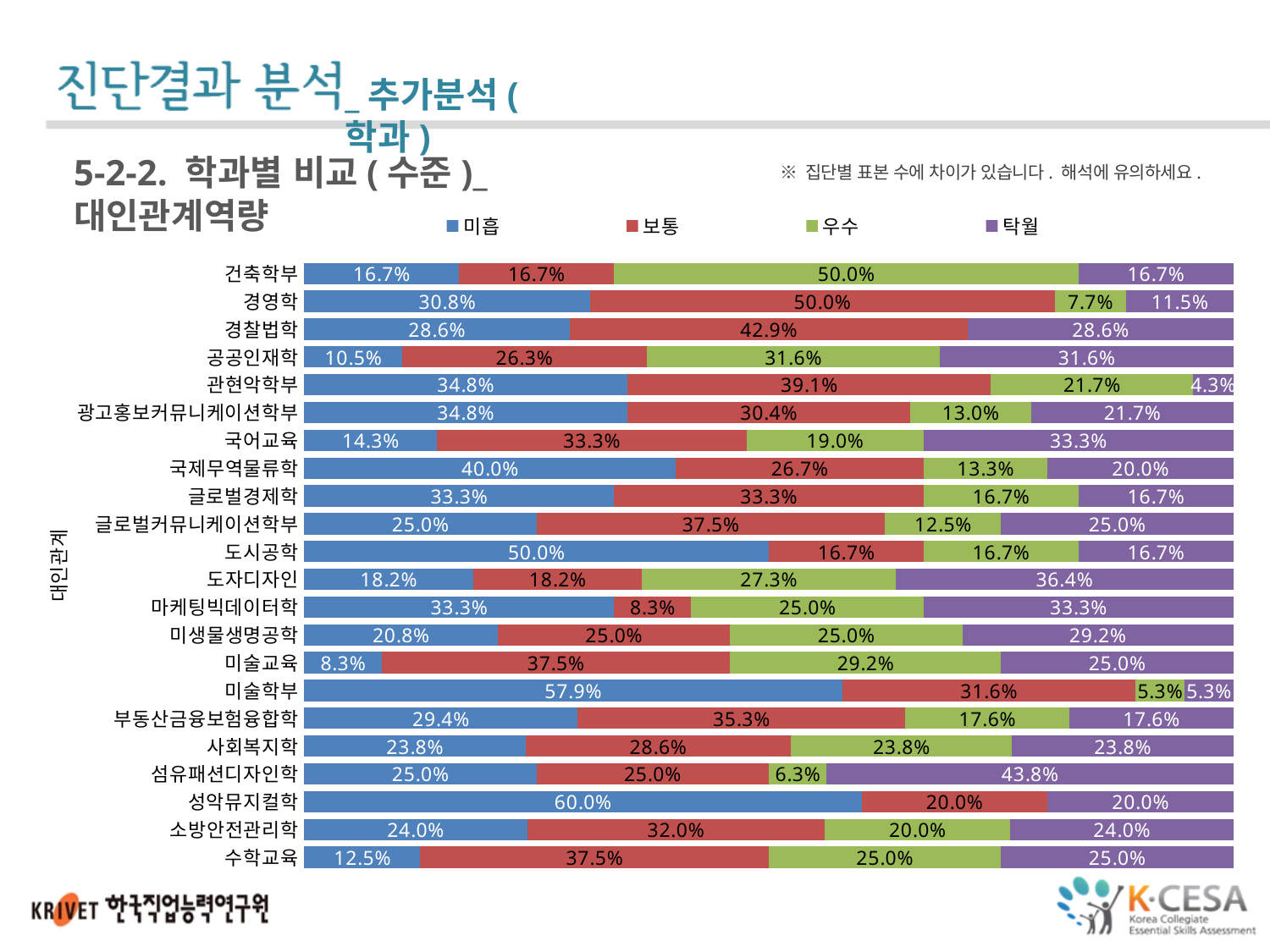
How many series does the legend list? 4 Which legend entry is shown in purple? 탁월 What kind of chart is shown on the slide? stacked bar chart What is the difference between the 미흡 value of 미술학부 and the 미흡 value of 경영학? 27.1% Which department has the highest 미흡 value? 성악뮤지컬학 Which is larger: the 탁월 value for 도자디자인 or the 탁월 value for 국제무역물류학? 도자디자인 What is the 우수 value for 건축학부? 50.0% What is the 탁월 value for 섬유패션디자인학? 43.8% How many departments (categories) are plotted in the chart? 22 What is the 미흡 value for 성악뮤지컬학? 60.0% Which department has the lowest 미흡 value? 미술교육 What is the 보통 value for 마케팅빅데이터학? 8.3%